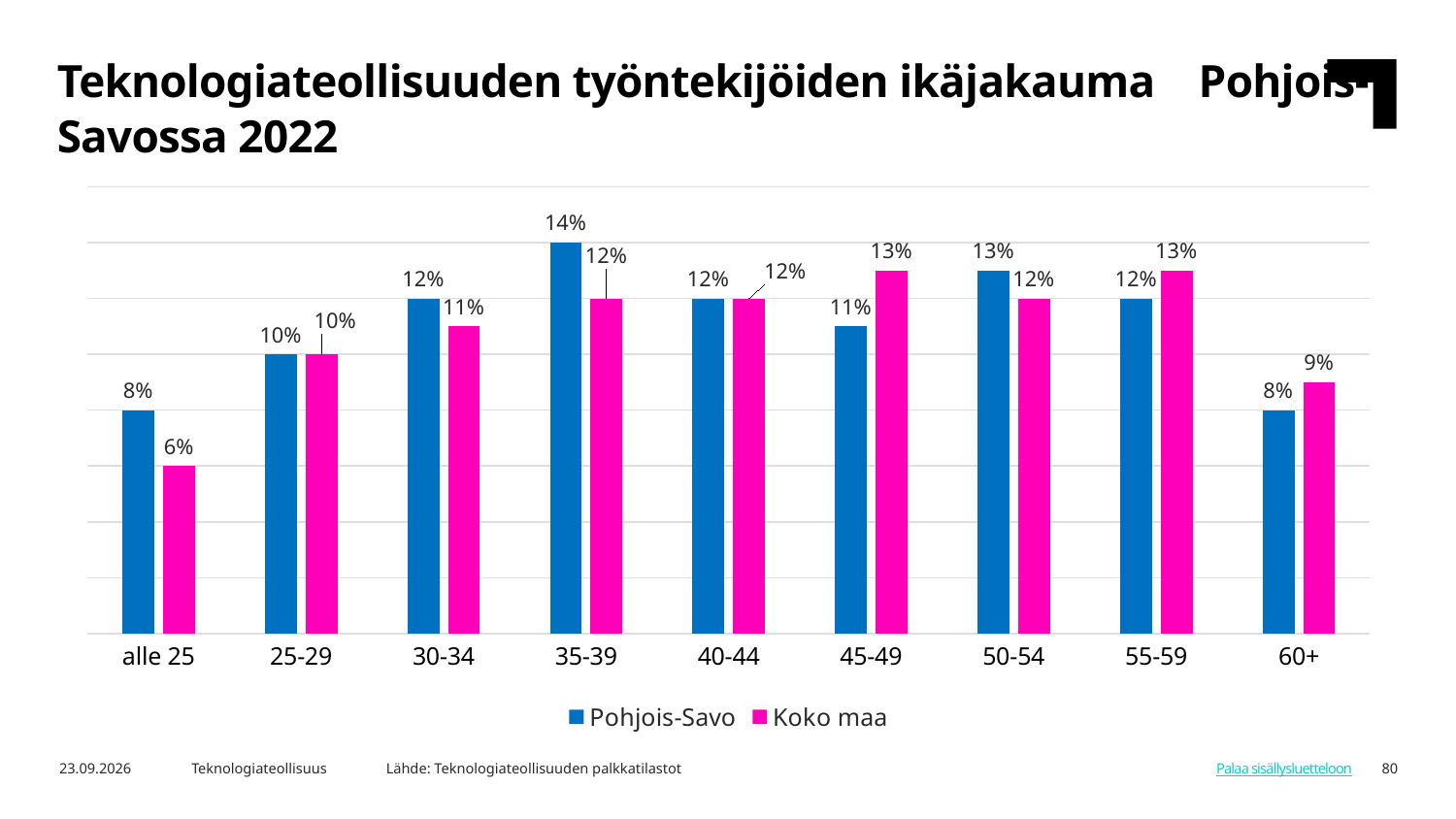
What is the Koko maa value for the alle 25 age group? 6% What is the Pohjois-Savo value for the 35-39 age group? 14% How many age groups are shown on the x axis? 9 Which age group has the highest Pohjois-Savo value? 35-39 Which age group has the lowest Koko maa value? alle 25 Which is larger for the 45-49 age group, the Pohjois-Savo value or the Koko maa value? Koko maa What kind of chart is shown on the slide? bar chart What is the difference between the Pohjois-Savo and Koko maa values for the alle 25 age group? 2% What is the Koko maa value for the 60+ age group? 9% Which series is shown in pink in the legend? Koko maa How many series does the legend list? 2 What is the Pohjois-Savo value for the 45-49 age group? 11%